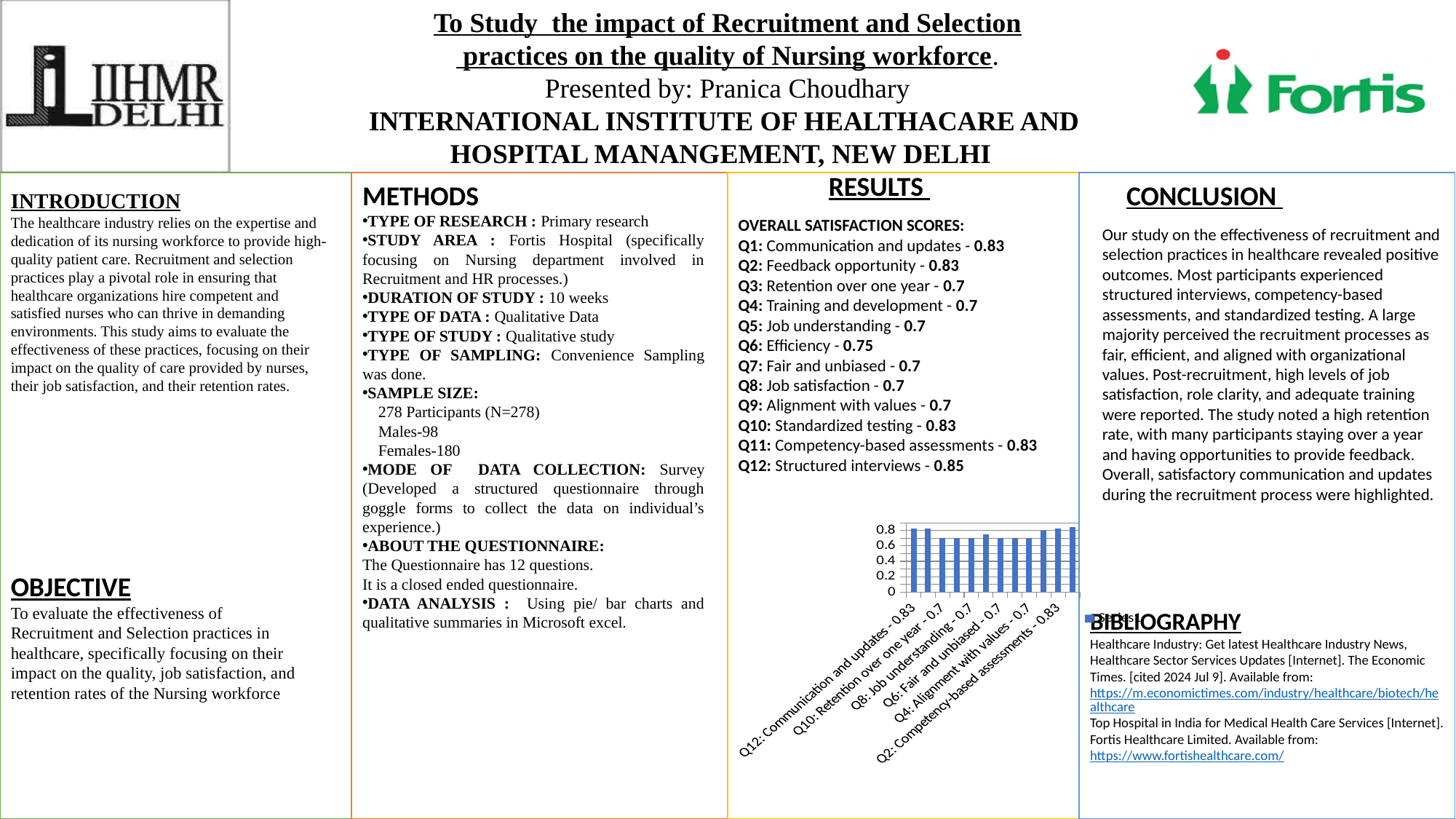
What value is given in the axis label 'Q10: Retention over one year' on the Results chart? 0.7 Is the value for 'Q10: Retention over one year' on the Results chart greater or less than 0.6? greater What value is given in the axis label 'Q2: Competency-based assessments' on the Results chart? 0.83 What is the name of the series in the legend of the Results chart? Series1 How many bars are plotted in the Results chart? 12 On the Results chart, what is the difference between the value for 'Q2: Competency-based assessments' and 'Q4: Alignment with values'? 0.13 On the Results chart, which is larger: the value for 'Q12: Communication and updates' or 'Q8: Job understanding'? Q12: Communication and updates What kind of chart is shown in the Results section? bar chart What is the highest tick value shown on the vertical axis of the Results chart? 0.8 What value is given in the axis label 'Q6: Fair and unbiased' on the Results chart? 0.7 How many series does the legend of the Results chart list? 1 What value is given in the axis label 'Q12: Communication and updates' on the Results chart? 0.83